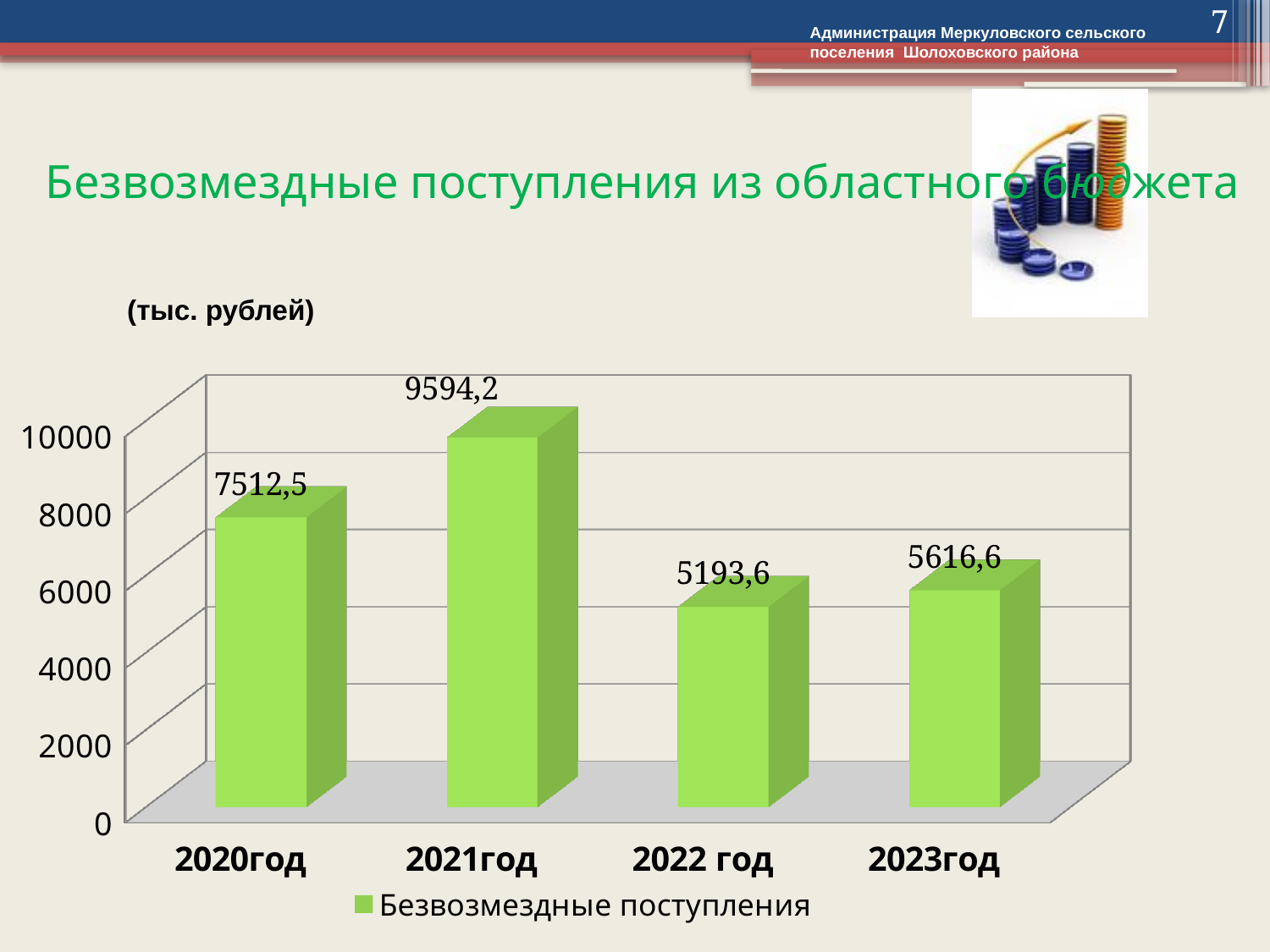
What series name does the legend show? Безвозмездные поступления What is the difference between the values for 2021год and 2020год? 2081,7 What is the value for 2020год? 7512,5 How many years are shown on the x axis? 4 Which year has the highest value? 2021год What kind of chart is shown on the slide? bar chart What is the value for 2022 год? 5193,6 What is the value for 2021год? 9594,2 Which is larger, the value for 2020год or the value for 2023год? 2020год What is the value for 2023год? 5616,6 Which year has the lowest value? 2022 год What is the difference between the values for 2023год and 2022 год? 423